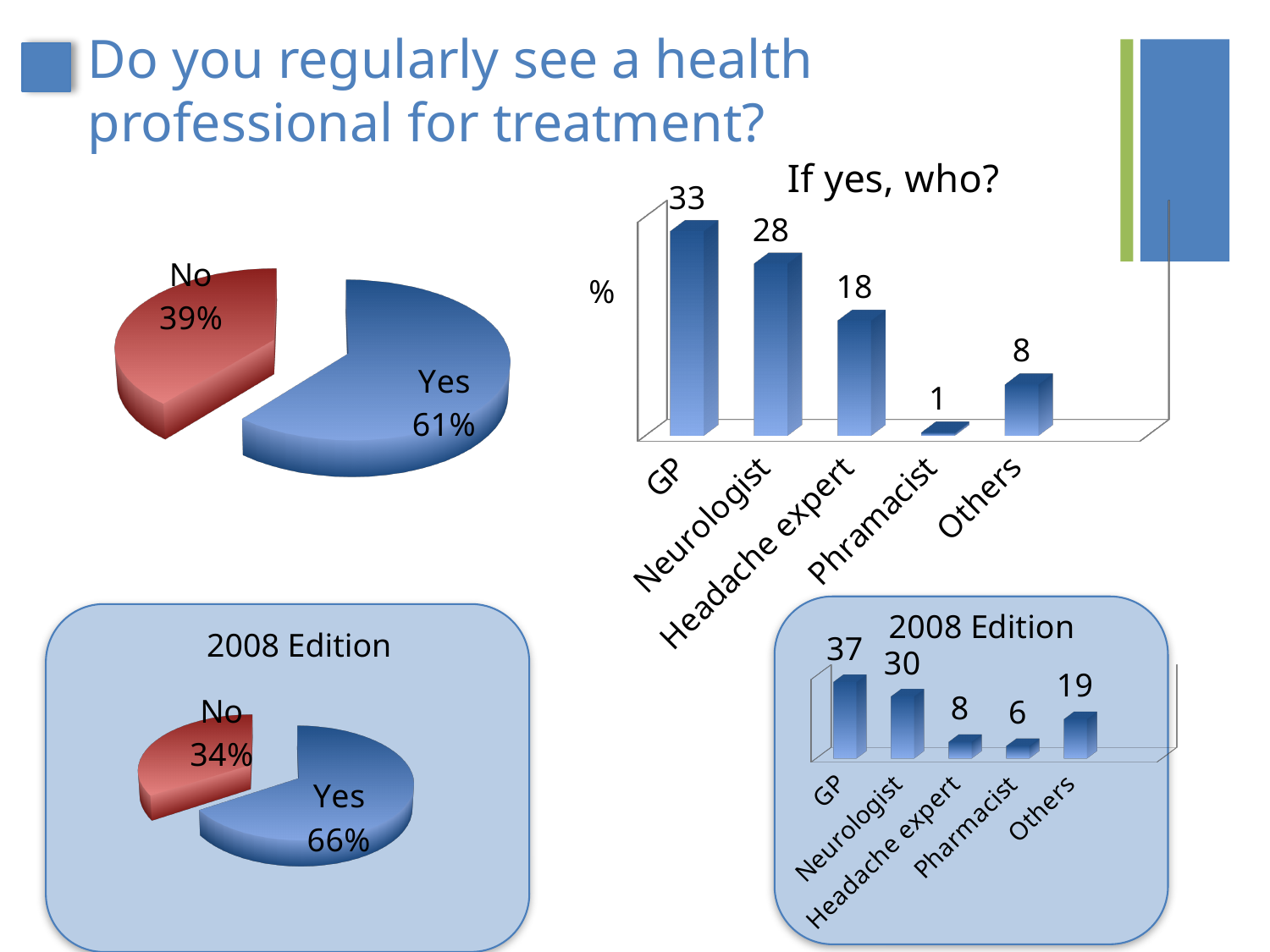
In the 'If yes, who?' bar chart at the top right, how many categories are shown? 5 In the bottom-right '2008 Edition' bar chart, which is larger, the value for Headache expert or the value for Pharmacist? Headache expert In the 'If yes, who?' bar chart at the top right, what is the difference between the values for GP and Headache expert? 15 In the 'If yes, who?' bar chart at the top right, what is the value for Neurologist? 28 In the top-left pie chart, what share of respondents answered No? 39% In the 'If yes, who?' bar chart at the top right, which category has the highest value? GP In the bottom-right '2008 Edition' bar chart, what is the difference between the values for GP and Neurologist? 7 What kind of chart is the 'If yes, who?' chart at the top right? Bar chart In the top-left pie chart, what share of respondents answered Yes? 61% In the bottom-right '2008 Edition' bar chart, what is the value for Others? 19 In the bottom-left '2008 Edition' pie chart, what share of respondents answered Yes? 66% In the 'If yes, who?' bar chart at the top right, which category has the lowest value? Phramacist